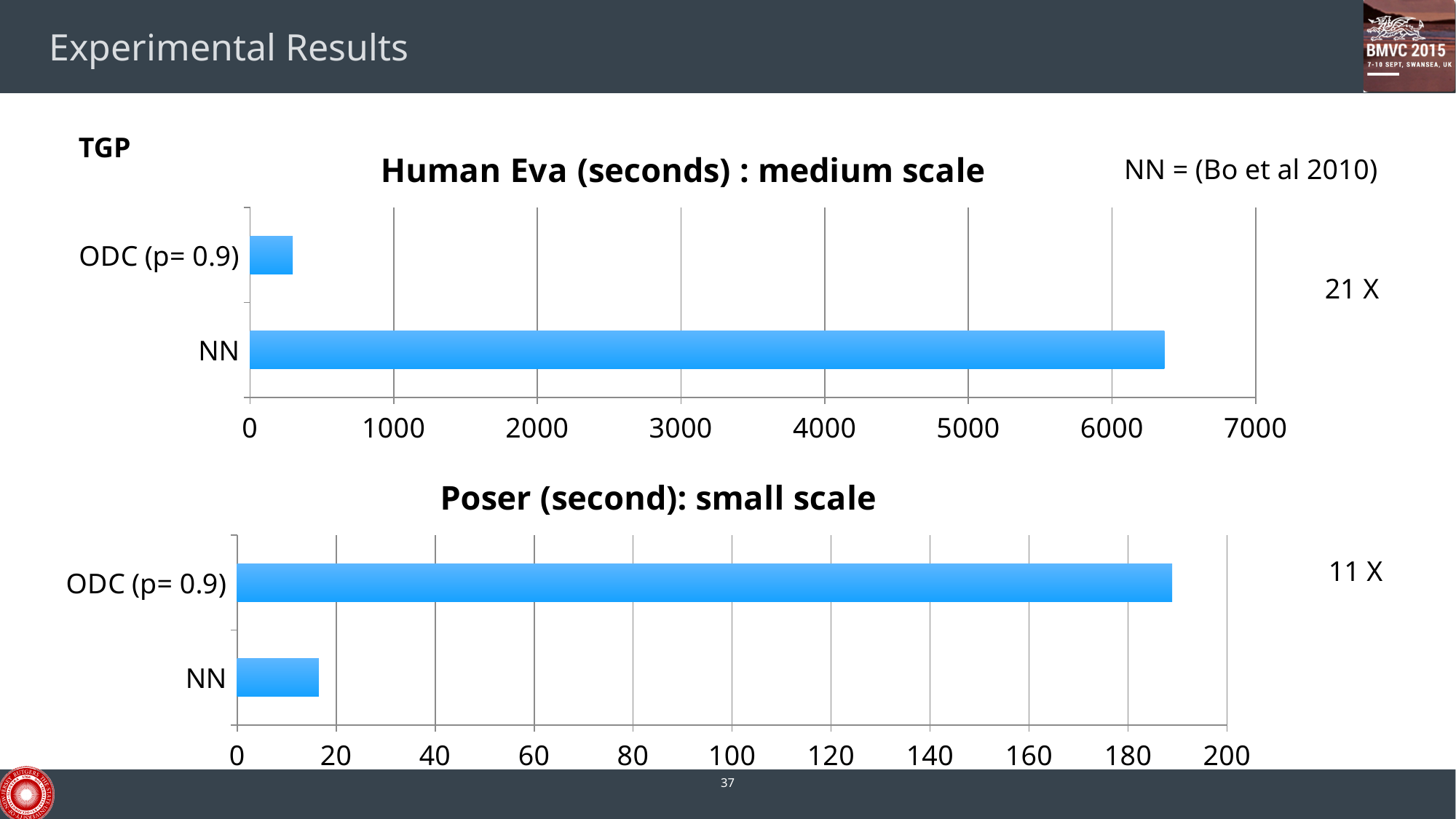
In the 'Poser (second): small scale' chart, which is larger, the value for NN or the value for ODC (p= 0.9)? ODC (p= 0.9) In the 'Human Eva (seconds) : medium scale' chart, is the value for NN greater or less than 6000? greater How many categories are shown in the 'Human Eva (seconds) : medium scale' chart? 2 In the 'Poser (second): small scale' chart, is the value for ODC (p= 0.9) greater or less than 180? greater In the 'Poser (second): small scale' chart, is the value for NN greater or less than 20? less In the 'Poser (second): small scale' chart, which category has the highest value? ODC (p= 0.9) What is the title of the top chart on the slide? Human Eva (seconds) : medium scale In the 'Human Eva (seconds) : medium scale' chart, which category has the lowest value? ODC (p= 0.9) What speed-up factor is annotated next to the 'Poser (second): small scale' chart? 11 X In the 'Human Eva (seconds) : medium scale' chart, which category has the highest value? NN What type of chart is the 'Poser (second): small scale' chart? bar chart